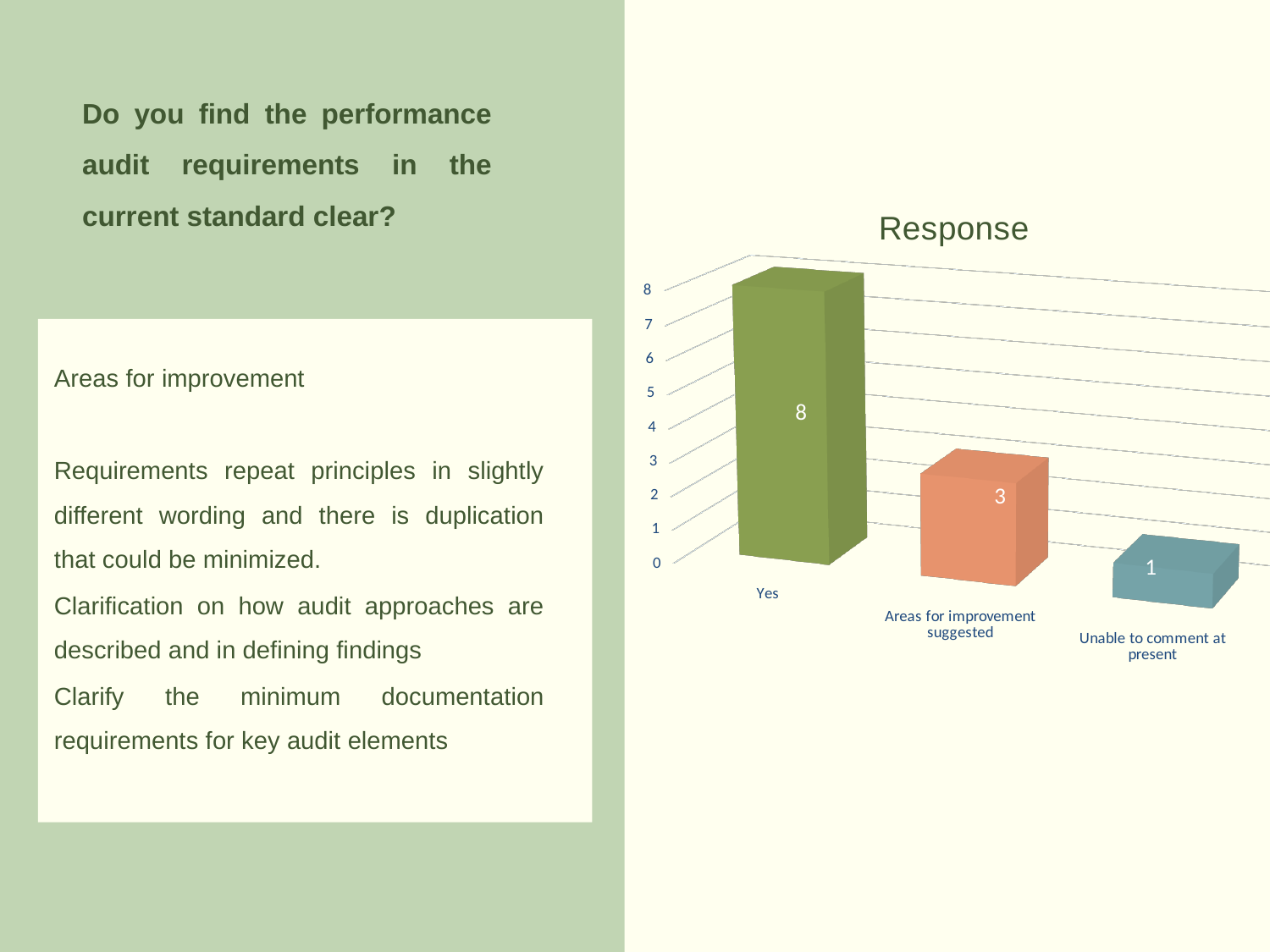
What is the difference between the values for "Yes" and "Areas for improvement suggested"? 5 Which category has the highest value? Yes What kind of chart is shown on the slide? bar chart Which is larger, the value for "Areas for improvement suggested" or the value for "Unable to comment at present"? Areas for improvement suggested How many categories are shown in the chart? 3 Which category has the lowest value? Unable to comment at present What is the difference between the values for "Areas for improvement suggested" and "Unable to comment at present"? 2 What is the value for "Yes"? 8 Is the value for "Yes" greater or less than 5? greater What is the value for "Unable to comment at present"? 1 What is the value for "Areas for improvement suggested"? 3 What is the title of the chart? Response